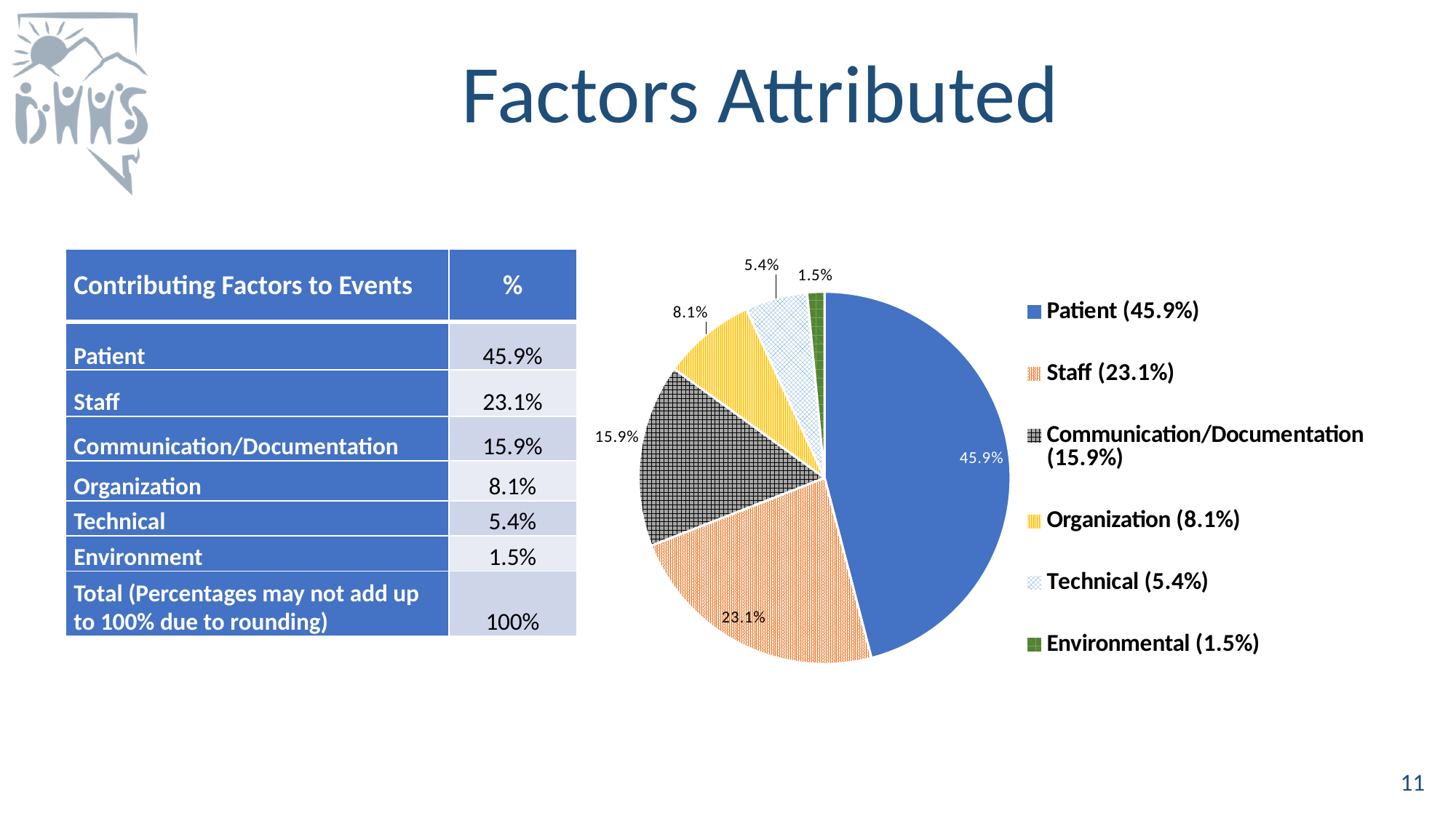
What is the difference between the Patient and Staff percentages? 22.8% Which category has the largest slice in the pie chart? Patient What is the value shown for Communication/Documentation in the pie chart? 15.9% How many slices does the pie chart have? 6 What is the value shown for Technical in the pie chart? 5.4% What is the difference between the Communication/Documentation and Organization percentages? 7.8% Which is larger, the Organization slice or the Technical slice? Organization What share of the pie does the Patient slice represent? 45.9% What is the value shown for Staff in the pie chart? 23.1% Which category has the smallest slice in the pie chart? Environmental What type of chart is shown on the slide? pie chart How many entries does the legend list? 6